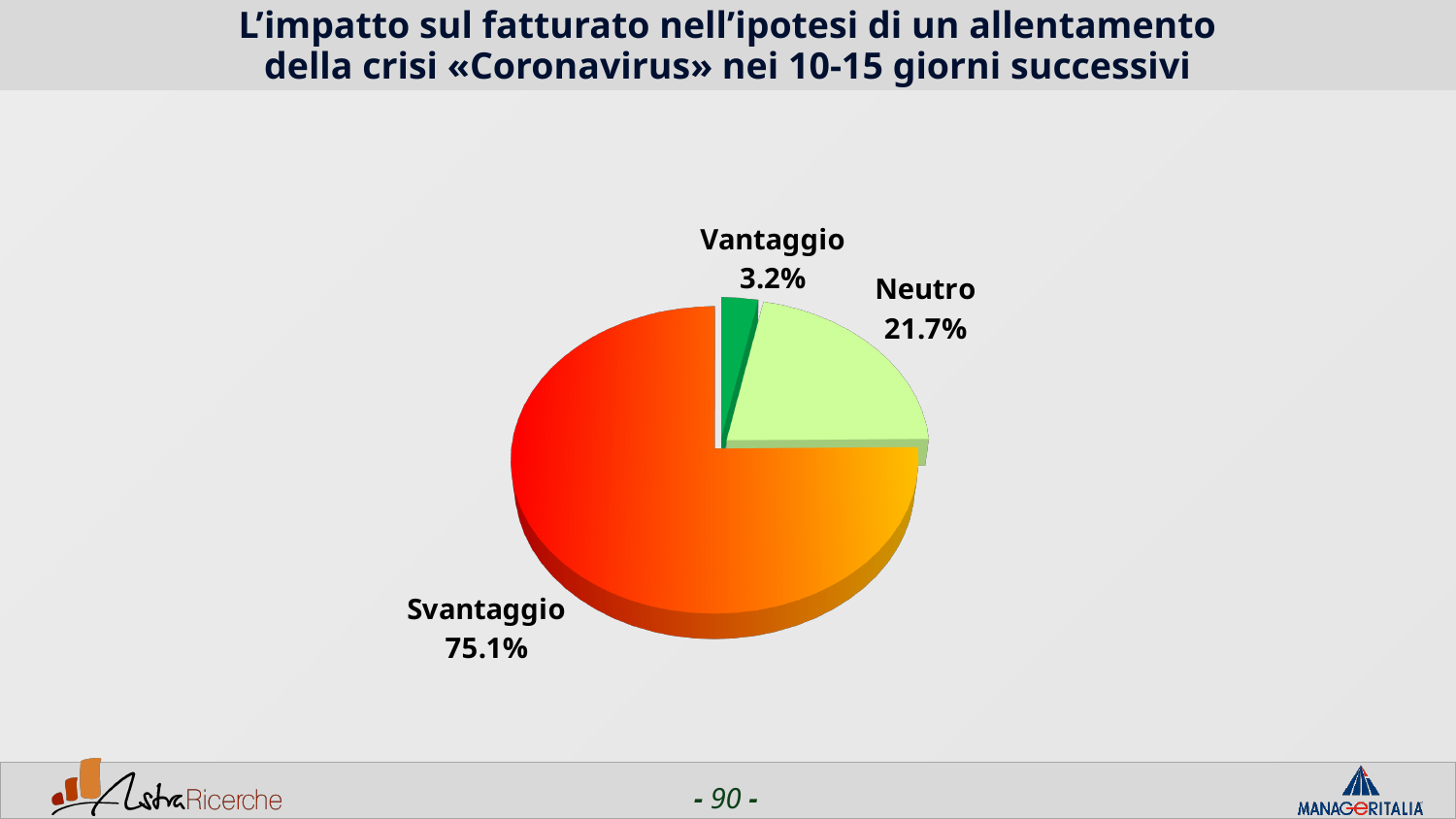
What is the value for Svantaggio? 75.1% Is the value for Svantaggio greater or less than 50%? greater What is the difference between the Neutro and Vantaggio values? 18.5% Which category has the smallest share of the pie? Vantaggio What colour is the Vantaggio slice? green What is the value for Vantaggio? 3.2% What kind of chart is shown on the slide? pie chart Which is larger, Neutro or Vantaggio? Neutro What is the value for Neutro? 21.7% What is the difference between the Svantaggio and Neutro values? 53.4% How many slices does the pie chart have? 3 Which category has the largest share of the pie? Svantaggio